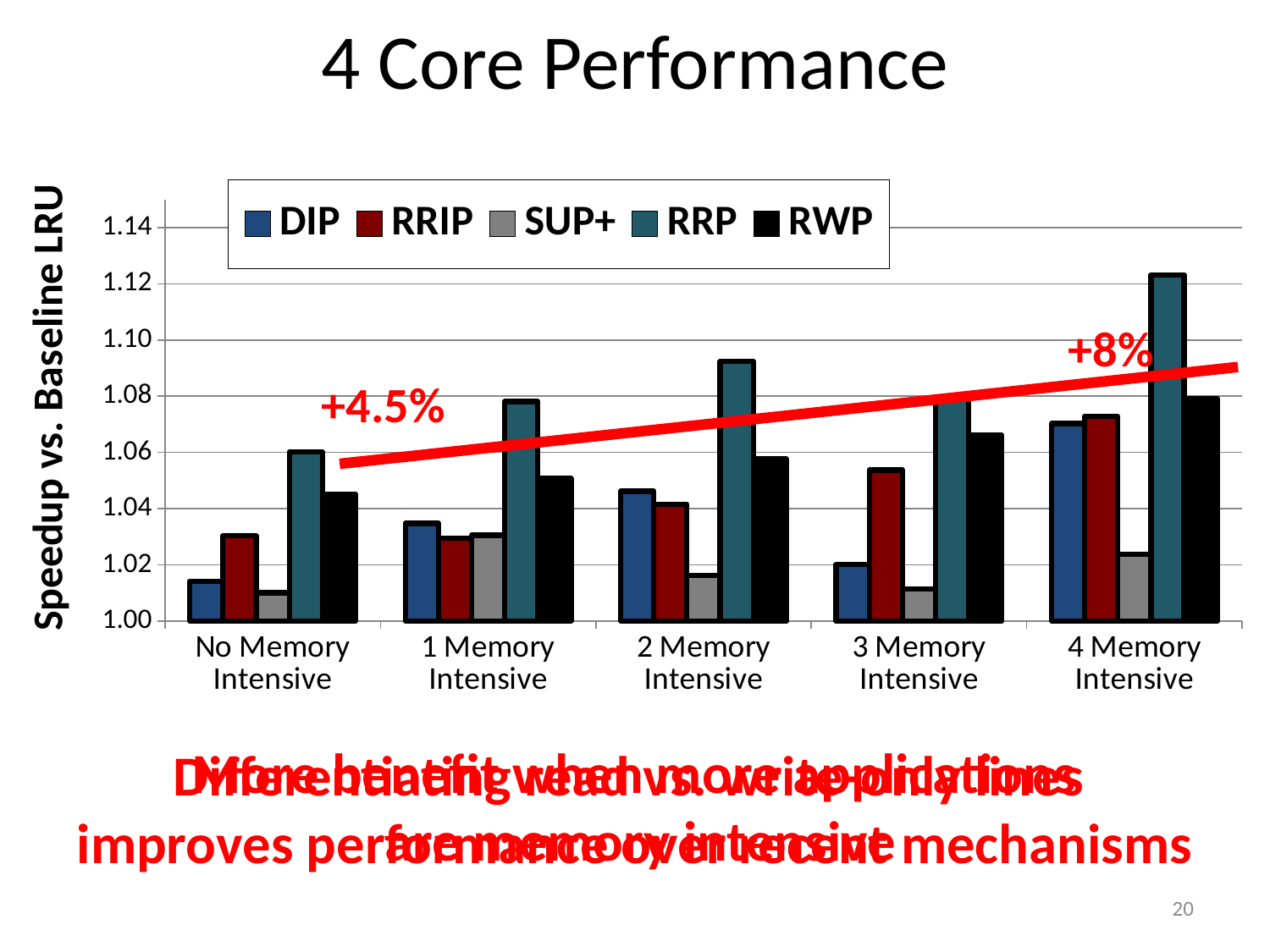
How many series does the legend list? 5 Is the value for RRP in the 2 Memory Intensive group greater or less than 1.08? greater Is the value for RRP in the 4 Memory Intensive group greater or less than 1.10? greater Do the RWP values rise or fall as you move from No Memory Intensive to 4 Memory Intensive? rise Which series has the highest bar in the 4 Memory Intensive group? RRP What kind of chart is shown on the slide? bar chart Is the value for DIP in the 3 Memory Intensive group greater or less than 1.04? less In the 3 Memory Intensive group, which is larger, DIP or RRIP? RRIP Which series has the lowest bar in the No Memory Intensive group? SUP+ What is the label of the y axis? Speedup vs. Baseline LRU How many categories are shown on the x axis? 5 In which category does the RRP series reach its highest value? 4 Memory Intensive